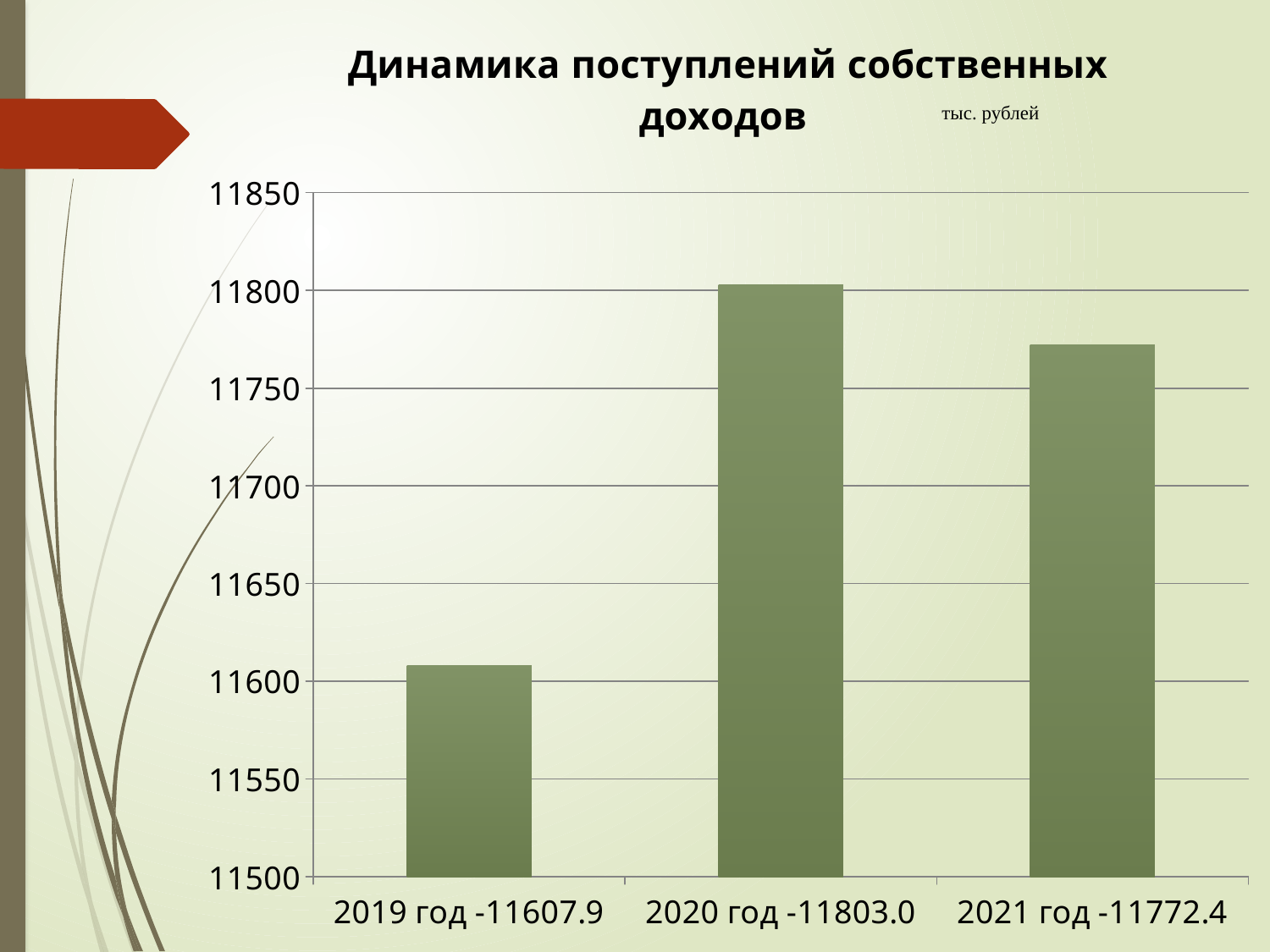
Which year has the highest value? 2020 год What is the value for 2019 год? 11607.9 What kind of chart is shown on the slide? bar chart What is the difference between the values for 2020 год and 2019 год? 195.1 Is the value for 2019 год greater or less than 11650? less Which is larger, the value for 2021 год or the value for 2019 год? 2021 год What is the value for 2020 год? 11803.0 How many bars are shown in the chart? 3 What is the value for 2021 год? 11772.4 Which year has the lowest value? 2019 год What unit is indicated next to the chart title? тыс. рублей What is the difference between the values for 2020 год and 2021 год? 30.6